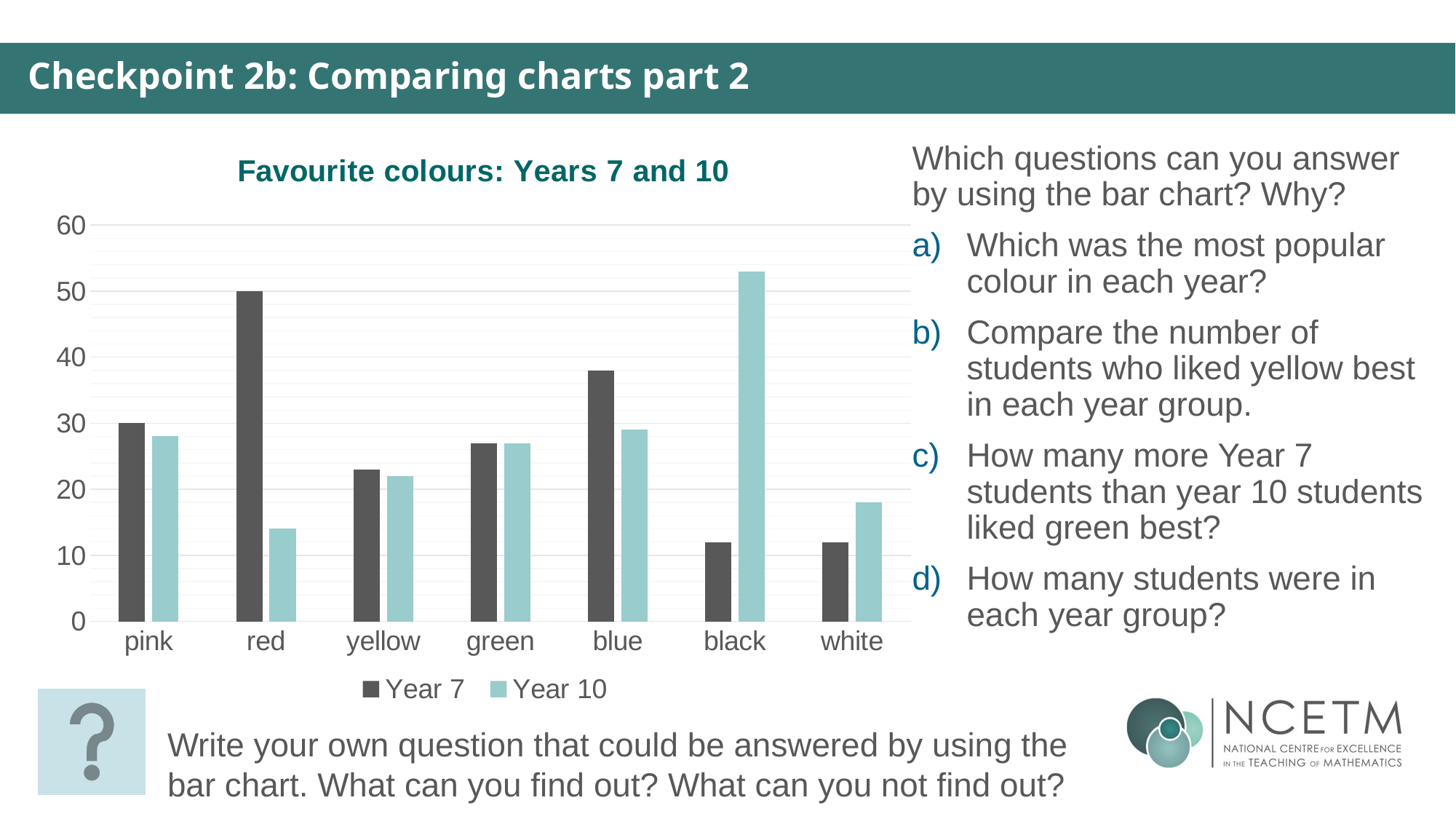
How many colour categories are shown on the x axis? 7 Which colour has the highest Year 10 value? black For blue, which is larger: the Year 7 value or the Year 10 value? Year 7 What is the Year 7 value for pink? 30 How many series does the legend list? 2 Is the Year 10 value for black greater or less than 50? greater What is the title of the chart? Favourite colours: Years 7 and 10 Is the Year 10 value for white greater or less than 20? less Which colour has the highest Year 7 value? red What type of chart is shown on the slide? bar chart Which colour has the lowest Year 10 value? red What is the Year 7 value for red? 50